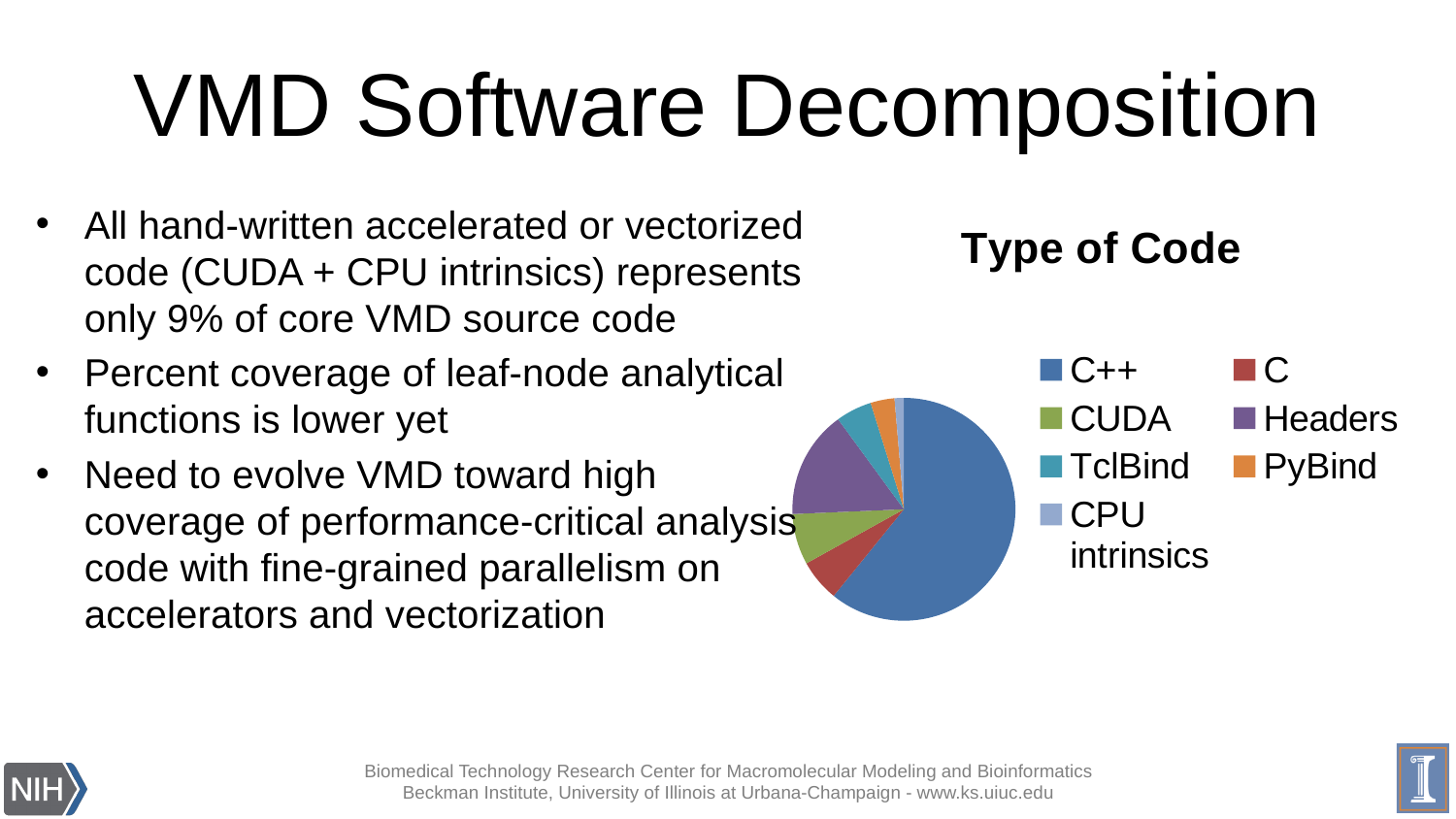
How many categories does the pie chart's legend list? 7 Which category has the largest slice of the pie? C++ Which slice is larger, C++ or CUDA? C++ What kind of chart is shown on the slide? pie chart Which slice is larger, Headers or PyBind? Headers Which category is shown in orange in the legend? PyBind What is the title of the chart? Type of Code Which slice is larger, C++ or Headers? C++ Which category has the smallest slice of the pie? CPU intrinsics